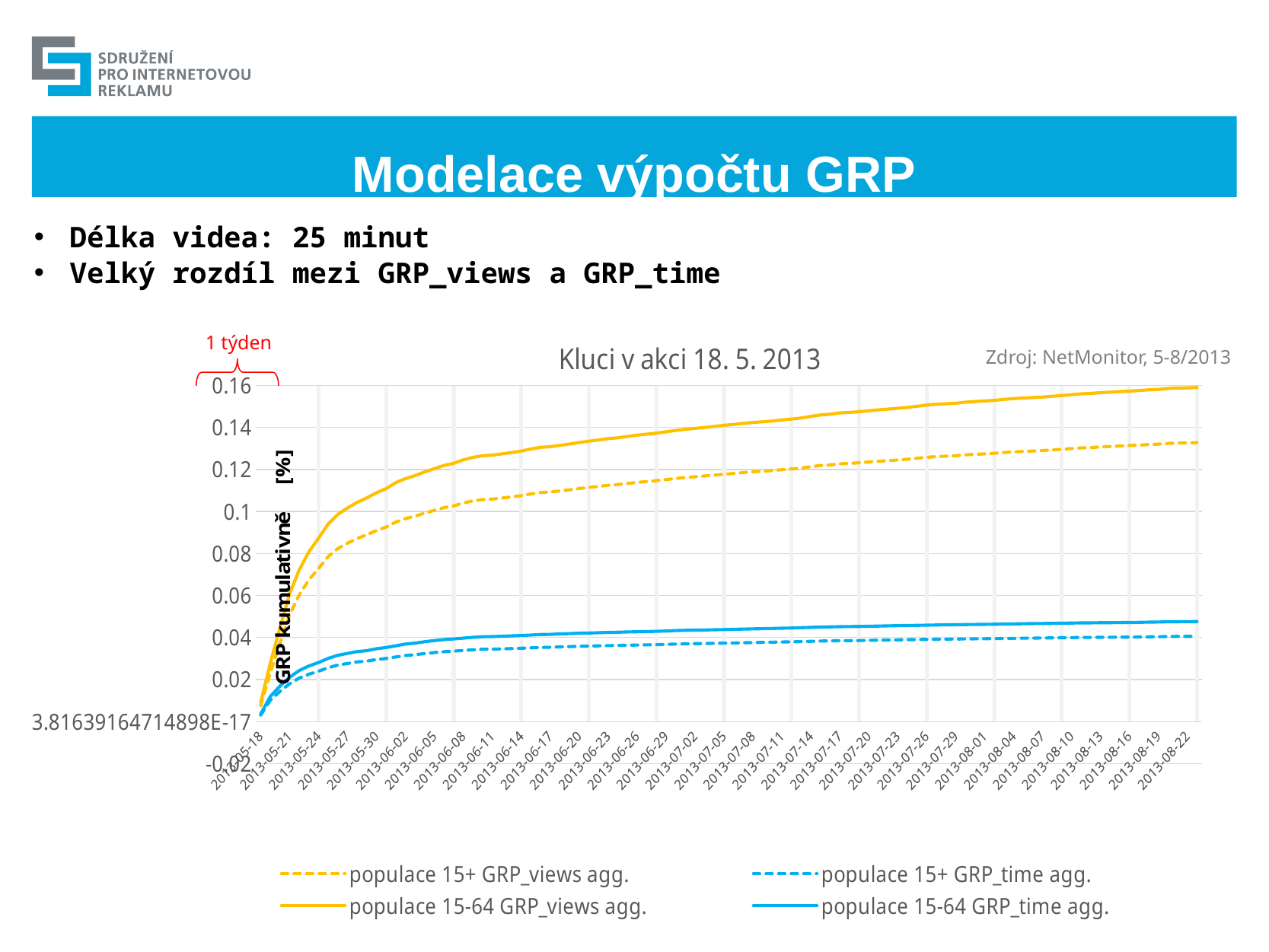
What kind of chart is shown on the slide? line chart Is the value for 'populace 15-64 GRP_views agg.' at 2013-08-22 greater or less than 0.14? greater How many series does the legend of the chart list? 4 Do the values of the series 'populace 15-64 GRP_views agg.' rise or fall along the x axis? rise At 2013-07-02, which is larger: 'populace 15+ GRP_views agg.' or 'populace 15+ GRP_time agg.'? populace 15+ GRP_views agg. What is the label of the vertical axis of the chart? GRP kumulativně [%] Which series reaches the highest value at the end of the period (2013-08-22)? populace 15-64 GRP_views agg. What is the title of the chart? Kluci v akci 18. 5. 2013 Is the value for 'populace 15+ GRP_time agg.' at 2013-08-22 greater or less than 0.06? less Is the value for 'populace 15+ GRP_views agg.' at 2013-08-22 greater or less than 0.12? greater At 2013-08-22, which is larger: 'populace 15-64 GRP_views agg.' or 'populace 15-64 GRP_time agg.'? populace 15-64 GRP_views agg. Which series has the lowest value at the end of the period (2013-08-22)? populace 15+ GRP_time agg.